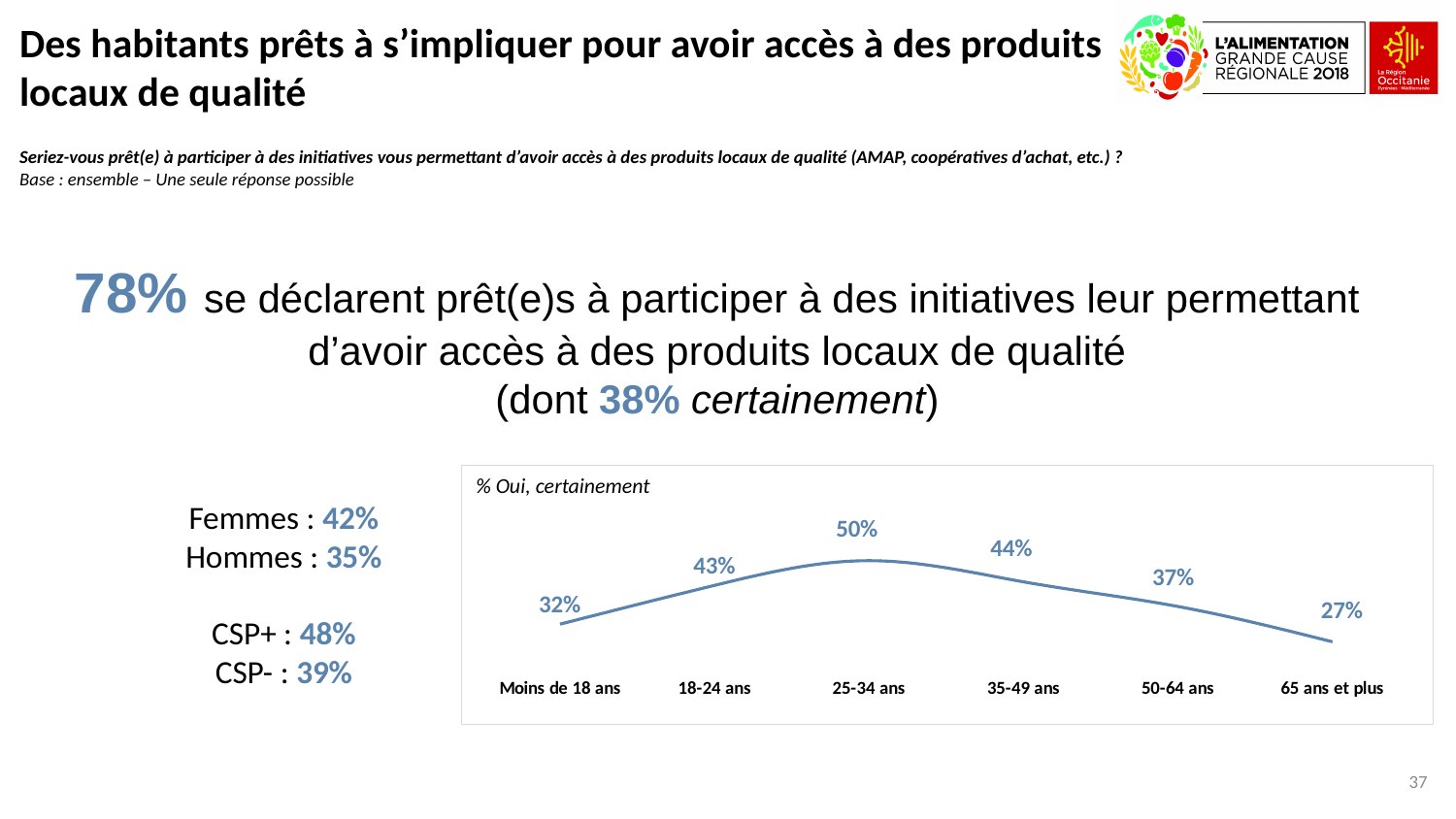
Which age group has the lowest value? 65 ans et plus What is the label shown at the top of the chart? % Oui, certainement What is the value for the 25-34 ans age group? 50% What is the difference between the values for 18-24 ans and 35-49 ans? 1% How many age groups are plotted on the chart? 6 Do the values rise or fall from 25-34 ans to 65 ans et plus? Fall What is the value for the 65 ans et plus age group? 27% What kind of chart is shown? Line chart What is the difference between the values for 25-34 ans and 65 ans et plus? 23% Which age group has a larger value, 50-64 ans or 18-24 ans? 18-24 ans What is the value for the Moins de 18 ans age group? 32% Which age group has the highest value? 25-34 ans